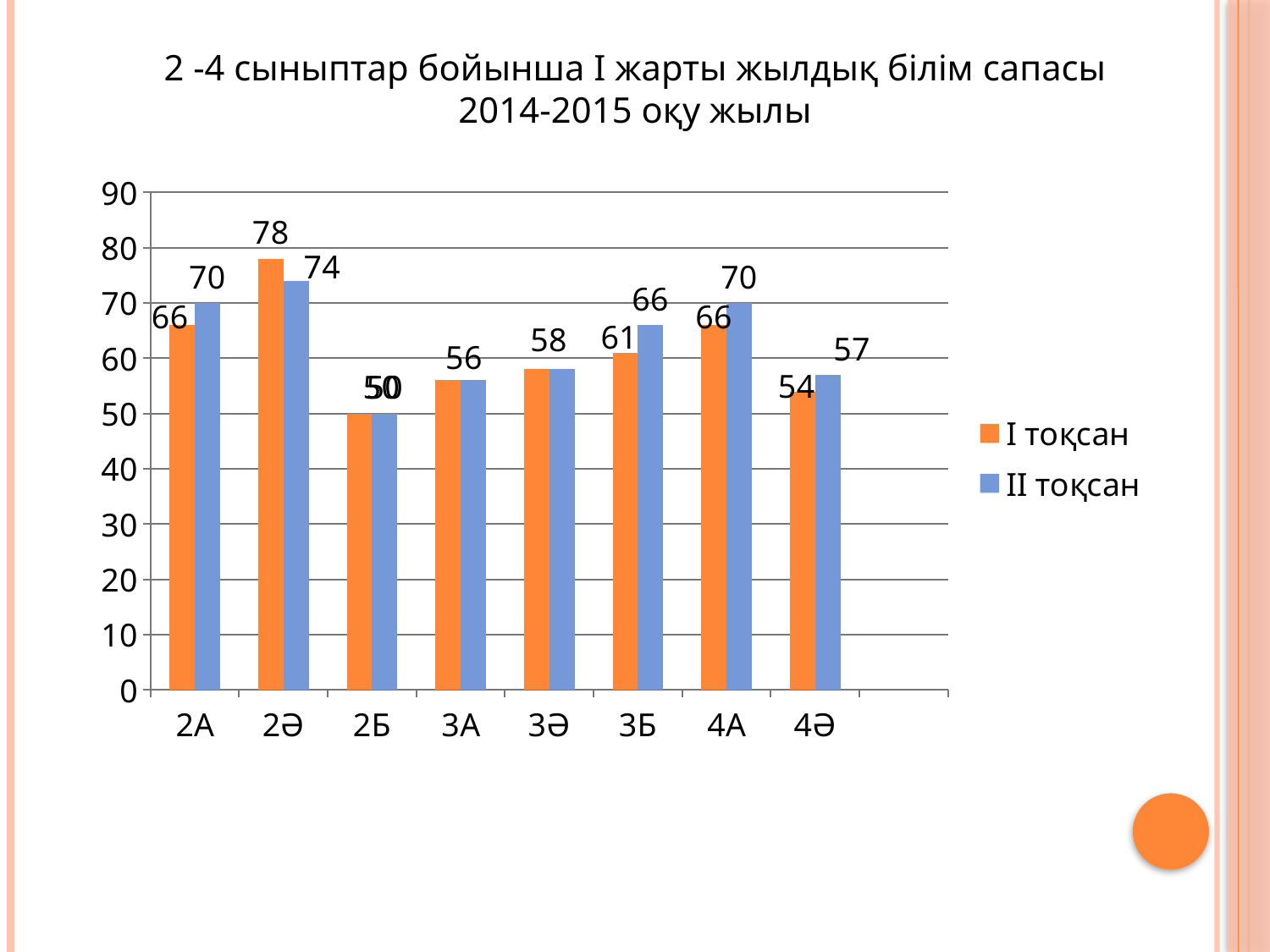
For 3Б, which is larger: I тоқсан or II тоқсан? II тоқсан What kind of chart is shown on the slide? bar chart What is the difference between the II тоқсан and I тоқсан values for 4Ә? 3 What is the value of II тоқсан for 4Ә? 57 What is the value of I тоқсан for 2Ә? 78 What is the value of I тоқсан for 3Б? 61 Which class has the lowest II тоқсан value? 2Б How many series does the legend list? 2 What is the difference between the I тоқсан and II тоқсан values for 2Ә? 4 How many classes are shown on the x axis? 8 Which class has the highest I тоқсан value? 2Ә Is the II тоқсан value for 4А greater or less than 60? greater